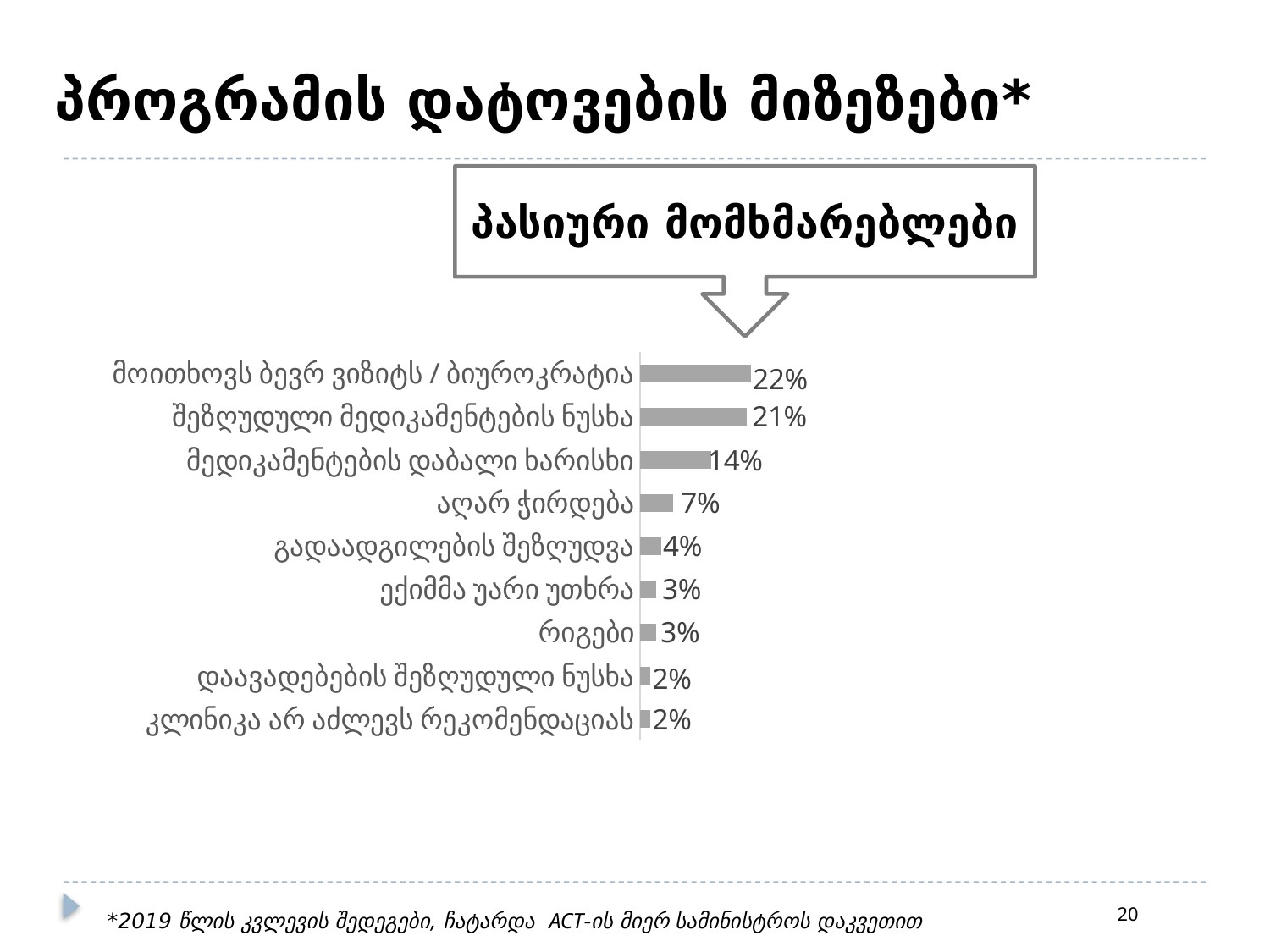
What is the value for "გადაადგილების შეზღუდვა"? 4% What is the value for "შეზღუდული მედიკამენტების ნუსხა"? 21% What is the difference between the values for "მოითხოვს ბევრ ვიზიტს / ბიუროკრატია" and "მედიკამენტების დაბალი ხარისხი"? 8% What kind of chart is shown on the slide? bar chart What is the title of the slide? პროგრამის დატოვების მიზეზები* Which is larger, the value for "აღარ ჭირდება" or the value for "რიგები"? აღარ ჭირდება What is the value for "მოითხოვს ბევრ ვიზიტს / ბიუროკრატია"? 22% What text is in the callout box above the chart? პასიური მომხმარებლები What is the value for "მედიკამენტების დაბალი ხარისხი"? 14% Which category has the highest value? მოითხოვს ბევრ ვიზიტს / ბიუროკრატია How many categories are shown in the chart? 9 What is the value for "აღარ ჭირდება"? 7%